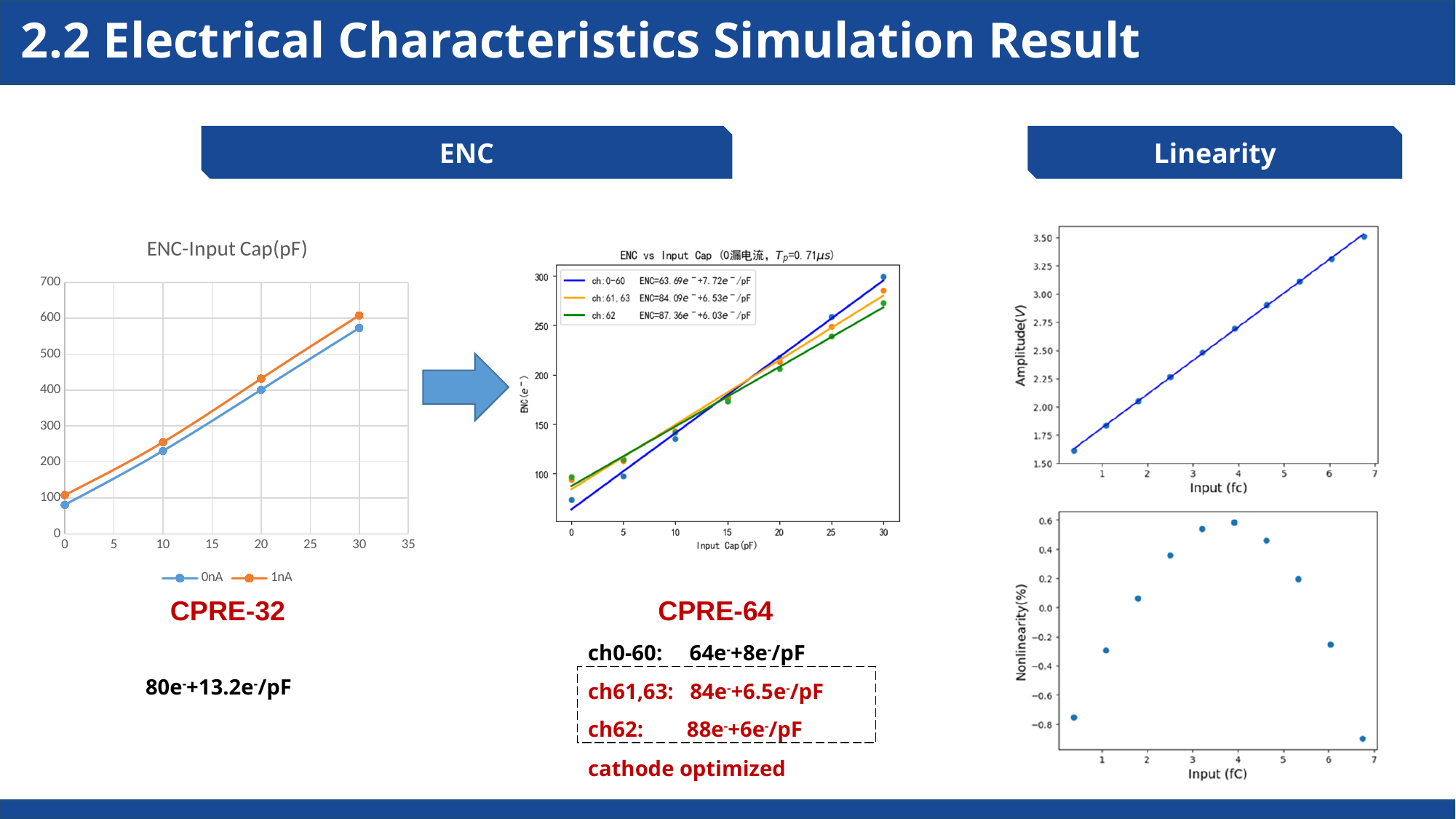
In the Amplitude vs Input chart under Linearity, does the amplitude rise or fall as input increases? rise In the ENC-Input Cap(pF) chart, how many data points does each series have? 4 In the ENC-Input Cap(pF) chart, what are the two legend entries? 0nA and 1nA In the ENC-Input Cap(pF) chart, do the ENC values rise or fall as input capacitance increases? rise In the ENC-Input Cap(pF) chart, is the 0nA value at 30 pF greater or less than 500? greater In the Nonlinearity chart, is the value at the rightmost point greater or less than -0.8? less In the ENC vs Input Cap chart (CPRE-64), is the ch:0-60 value at 30 pF greater or less than 250? greater In the ENC vs Input Cap chart (CPRE-64), how many series does the legend list? 3 In the ENC-Input Cap(pF) chart, which series has the higher ENC at 30 pF, 0nA or 1nA? 1nA In the ENC vs Input Cap chart (CPRE-64), which series has the highest ENC at 30 pF? ch:0-60 In the ENC-Input Cap(pF) chart, how many series does the legend list? 2